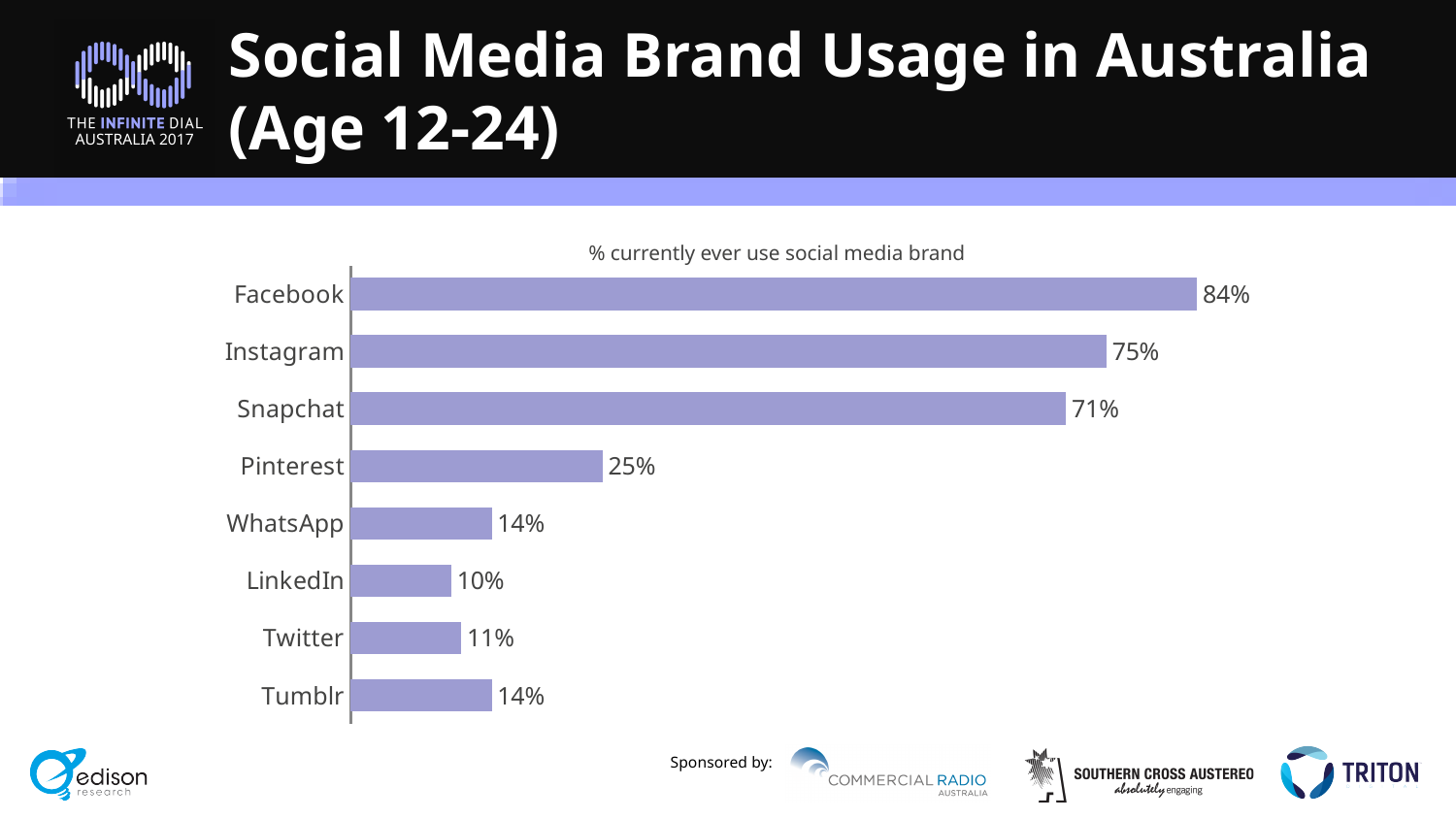
What is the difference between the values for Facebook and Instagram? 9% What is the value shown for LinkedIn? 10% What is the subtitle printed above the chart? % currently ever use social media brand Which social media brand has the highest usage on the chart? Facebook How many social media brands are shown on the chart? 8 What percentage of Australians aged 12-24 currently ever use Facebook? 84% What kind of chart is shown on the slide? Bar chart What is the difference between the values for Snapchat and Pinterest? 46% Which social media brand has the lowest usage on the chart? LinkedIn What is the value shown for Snapchat? 71% What is the value shown for Pinterest? 25% Which has a larger value, Instagram or Snapchat? Instagram